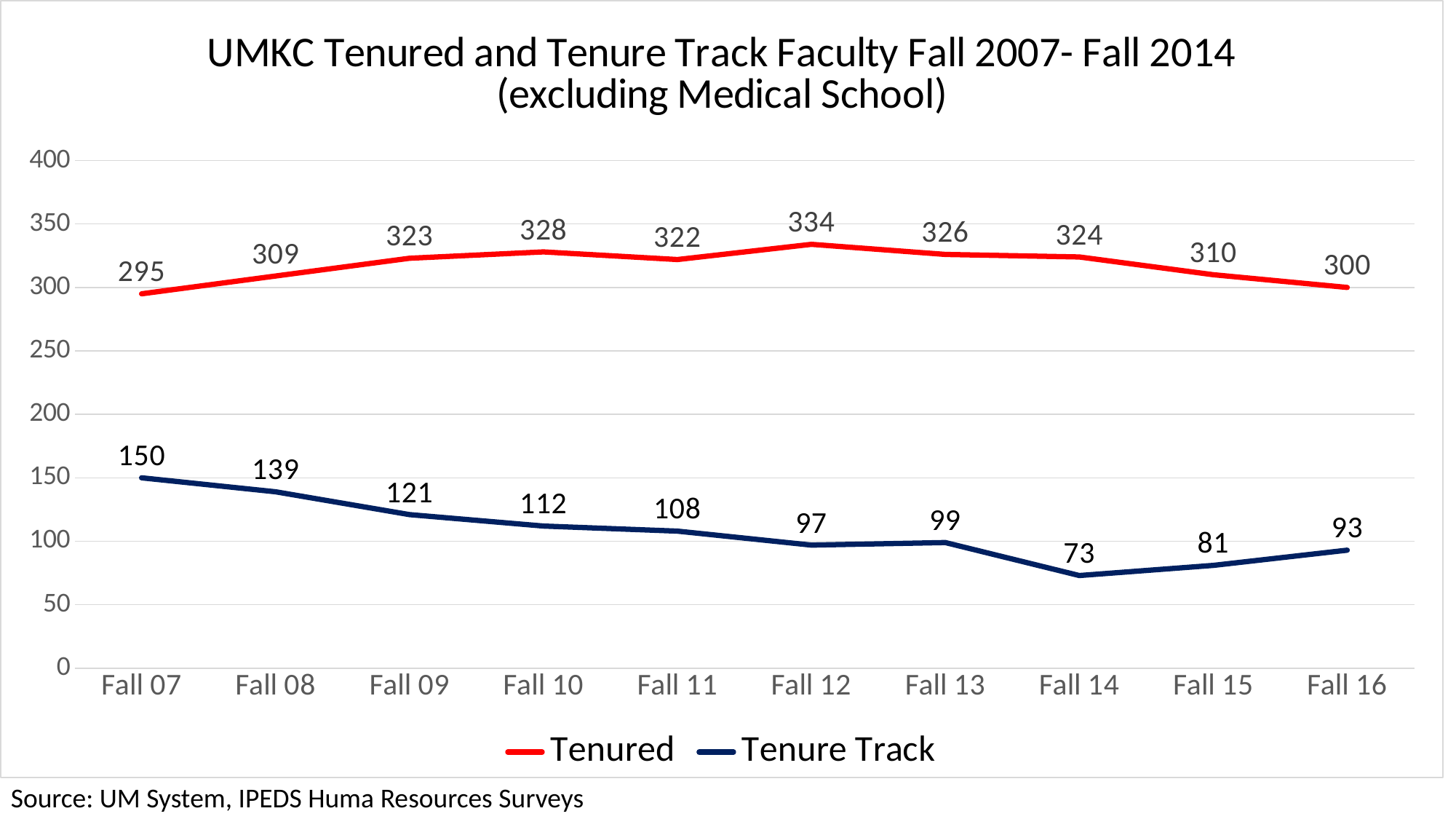
Which is larger, the Tenure Track value for Fall 08 or for Fall 15? Fall 08 Does the Tenure Track series generally rise or fall from Fall 07 to Fall 14? Fall How many series does the legend list? 2 In which period is the Tenure Track series highest? Fall 07 What is the Tenured value for Fall 07? 295 In which period is the Tenured series highest? Fall 12 What is the Tenured value for Fall 12? 334 How many periods are shown on the x axis? 10 In which period is the Tenure Track series lowest? Fall 14 What kind of chart is shown? Line chart What is the Tenure Track value for Fall 14? 73 What is the difference between the Tenured and Tenure Track values in Fall 16? 207